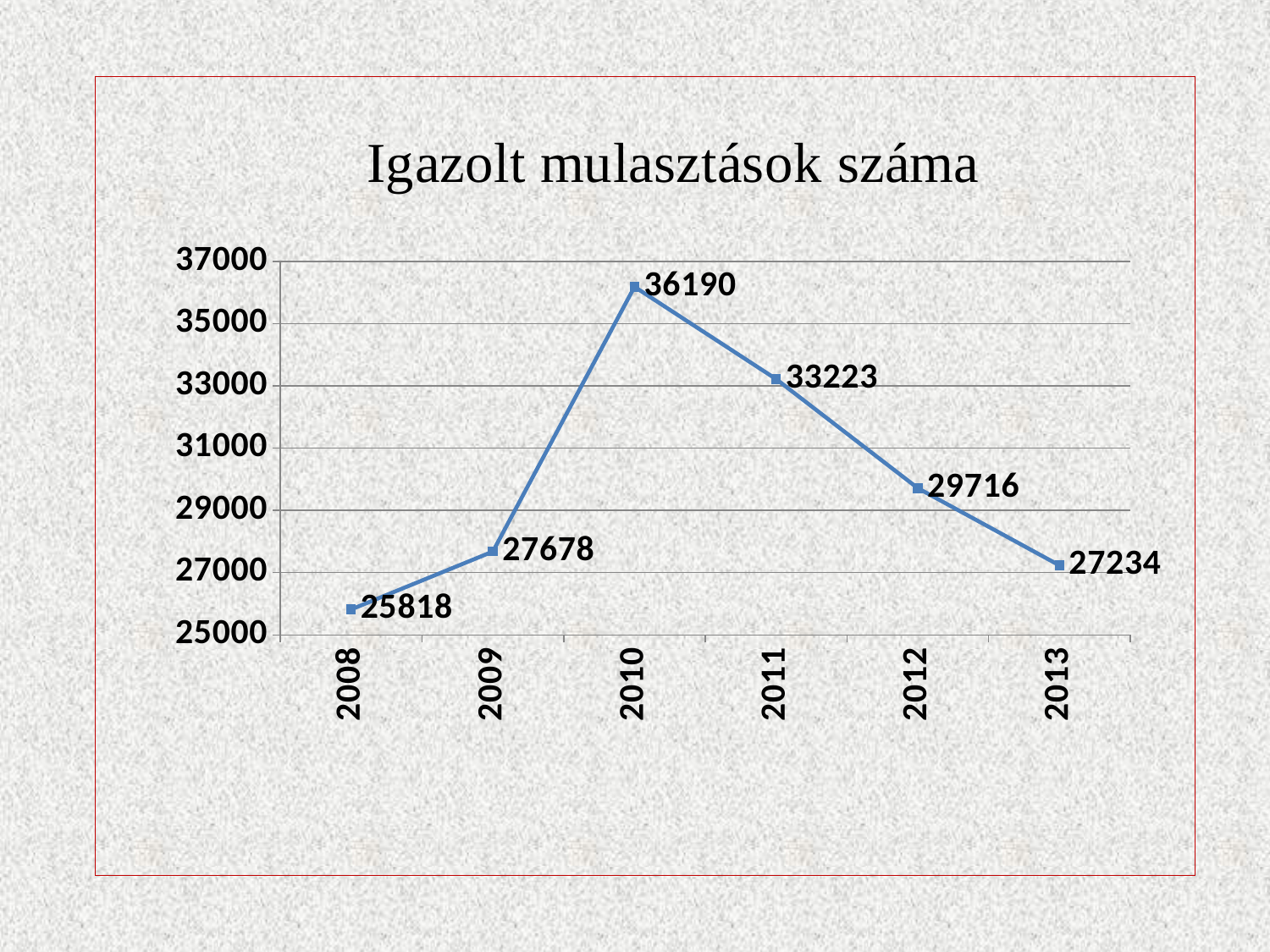
Which year has the highest value? 2010 Is the value for 2012 greater or less than 29000? greater What is the difference between the values for 2010 and 2011? 2967 How many years are plotted on the chart? 6 What is the value for 2010? 36190 What is the value for 2008? 25818 Which is larger, the value for 2011 or the value for 2013? 2011 What kind of chart is shown on the slide? line chart What is the title of the chart? Igazolt mulasztások száma What is the value for 2012? 29716 Which year has the lowest value? 2008 What is the difference between the values for 2009 and 2008? 1860